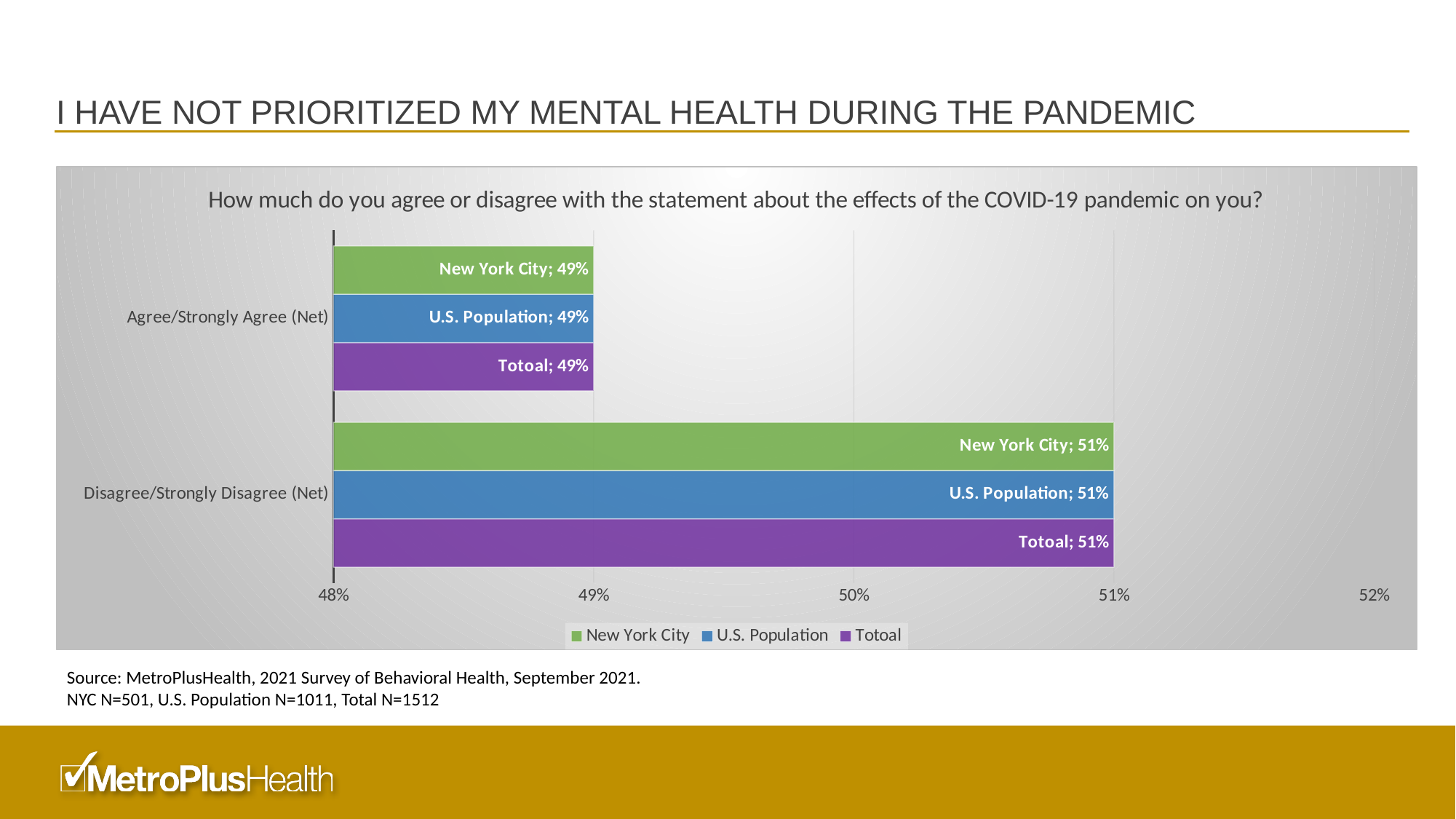
What is the difference between the Totoal values for Disagree/Strongly Disagree (Net) and Agree/Strongly Agree (Net)? 2% What colour are the U.S. Population bars? Blue Which category has the higher value for New York City: Agree/Strongly Agree (Net) or Disagree/Strongly Disagree (Net)? Disagree/Strongly Disagree (Net) What is the value for New York City in the Agree/Strongly Agree (Net) category? 49% Is the value for New York City in the Agree/Strongly Agree (Net) category greater or less than 50%? less What kind of chart is shown on the slide? Bar chart How many series does the legend list? 3 How many categories are shown on the chart? 2 What is the value for U.S. Population in the Disagree/Strongly Disagree (Net) category? 51% What is the value for New York City in the Disagree/Strongly Disagree (Net) category? 51% What is the value for Totoal in the Agree/Strongly Agree (Net) category? 49% Is the value for U.S. Population in the Disagree/Strongly Disagree (Net) category greater or less than 50%? greater